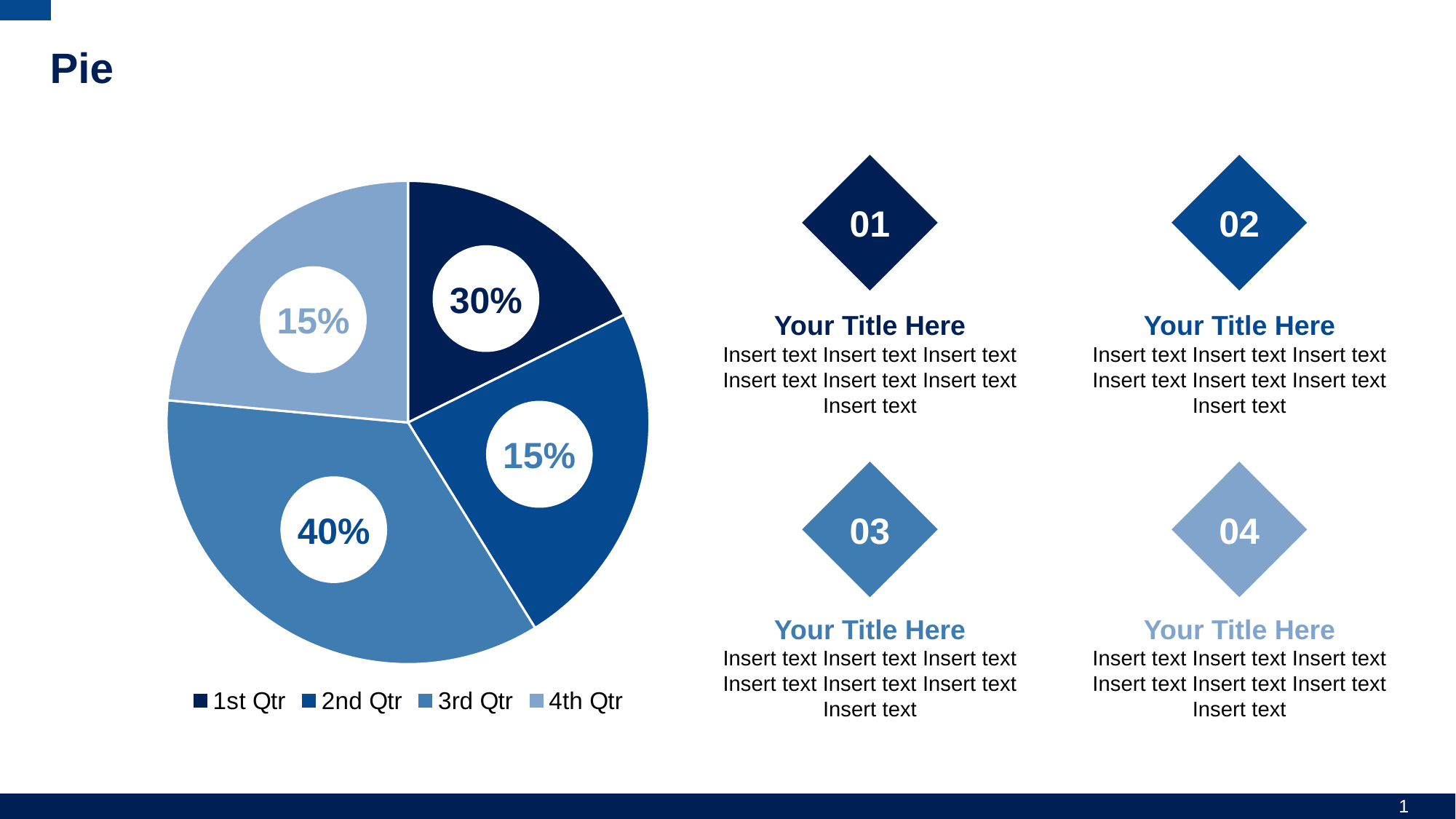
What kind of chart is shown on the slide? pie chart How many slices does the pie chart have? 4 Which legend entry is shown in the lightest blue in the pie chart? 4th Qtr What is the difference between the values for 3rd Qtr and 1st Qtr in the pie chart? 10% How many entries does the legend of the pie chart list? 4 What is the value for 4th Qtr in the pie chart? 15% Which is larger in the pie chart, 1st Qtr or 2nd Qtr? 1st Qtr What share of the pie does 3rd Qtr represent? 40% What is the value for 3rd Qtr in the pie chart? 40% What is the value for 1st Qtr in the pie chart? 30% What is the value for 2nd Qtr in the pie chart? 15% Which category has the largest slice in the pie chart? 3rd Qtr